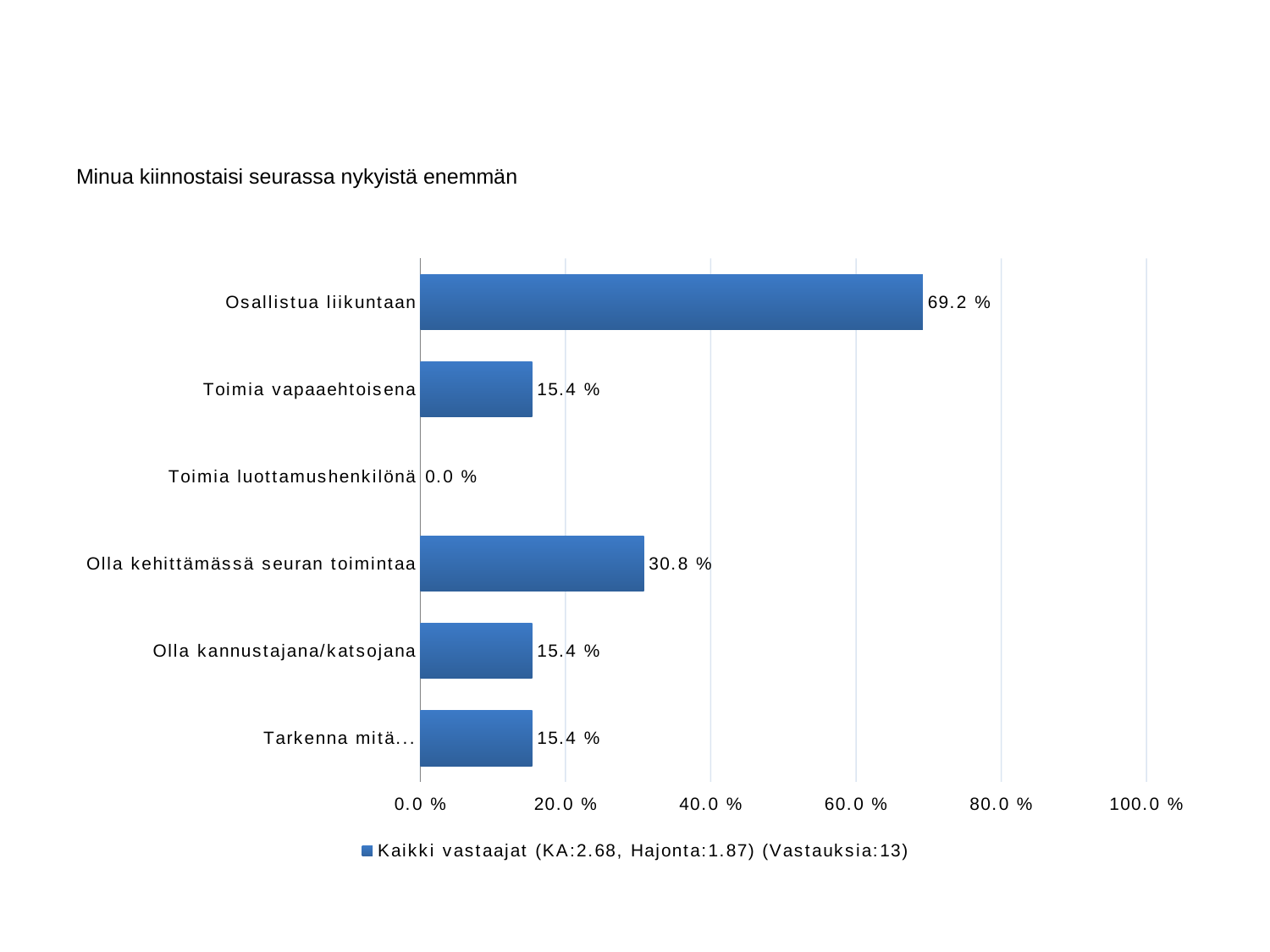
How many categories are shown in the chart? 6 What is the title of the chart? Minua kiinnostaisi seurassa nykyistä enemmän What is the value for Toimia luottamushenkilönä? 0.0 % What is the value for Olla kehittämässä seuran toimintaa? 30.8 % What kind of chart is shown on the slide? bar chart What is the value for Osallistua liikuntaan? 69.2 % What is the value for Toimia vapaaehtoisena? 15.4 % Is the value for Osallistua liikuntaan greater or less than 60.0 %? greater Which is larger, the value for Olla kehittämässä seuran toimintaa or the value for Olla kannustajana/katsojana? Olla kehittämässä seuran toimintaa What is the difference between the values for Osallistua liikuntaan and Olla kehittämässä seuran toimintaa? 38.4 % Which category has the lowest value? Toimia luottamushenkilönä Which category has the highest value? Osallistua liikuntaan